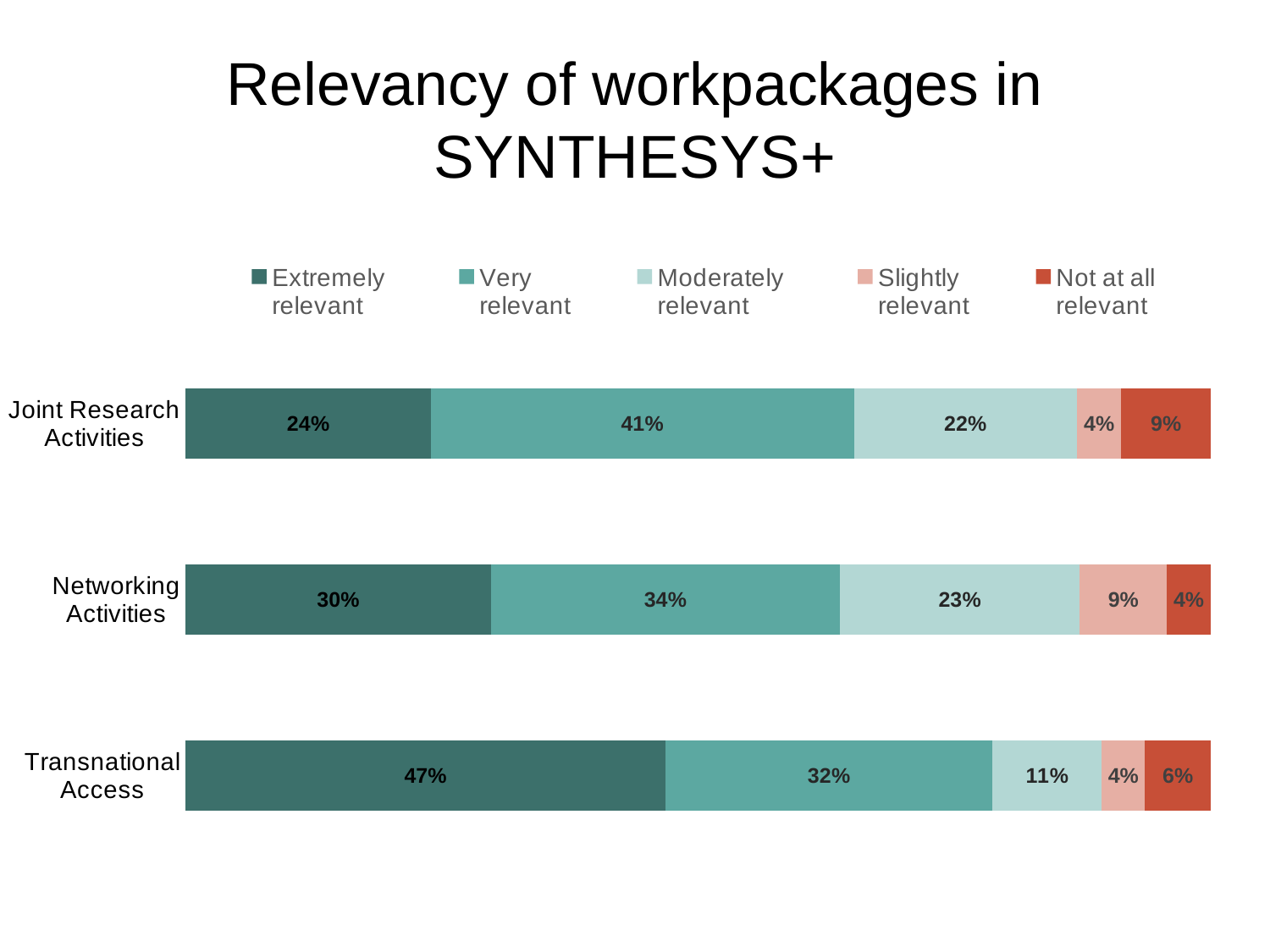
How many workpackages are shown in the chart? 3 What percentage of respondents rated Transnational Access as extremely relevant? 47% What is the 'Slightly relevant' value for Networking Activities? 9% Which workpackage has the highest 'Extremely relevant' share? Transnational Access Which workpackage has the lowest 'Moderately relevant' share? Transnational Access What kind of chart is shown on the slide? Stacked bar chart How many series does the legend list? 5 What is the 'Very relevant' value for Joint Research Activities? 41% What is the difference between the 'Extremely relevant' values for Transnational Access and Joint Research Activities? 23% Is the 'Not at all relevant' share larger for Joint Research Activities or for Networking Activities? Joint Research Activities What is the combined share of 'Extremely relevant' and 'Very relevant' for Networking Activities? 64% What is the title of the chart? Relevancy of workpackages in SYNTHESYS+